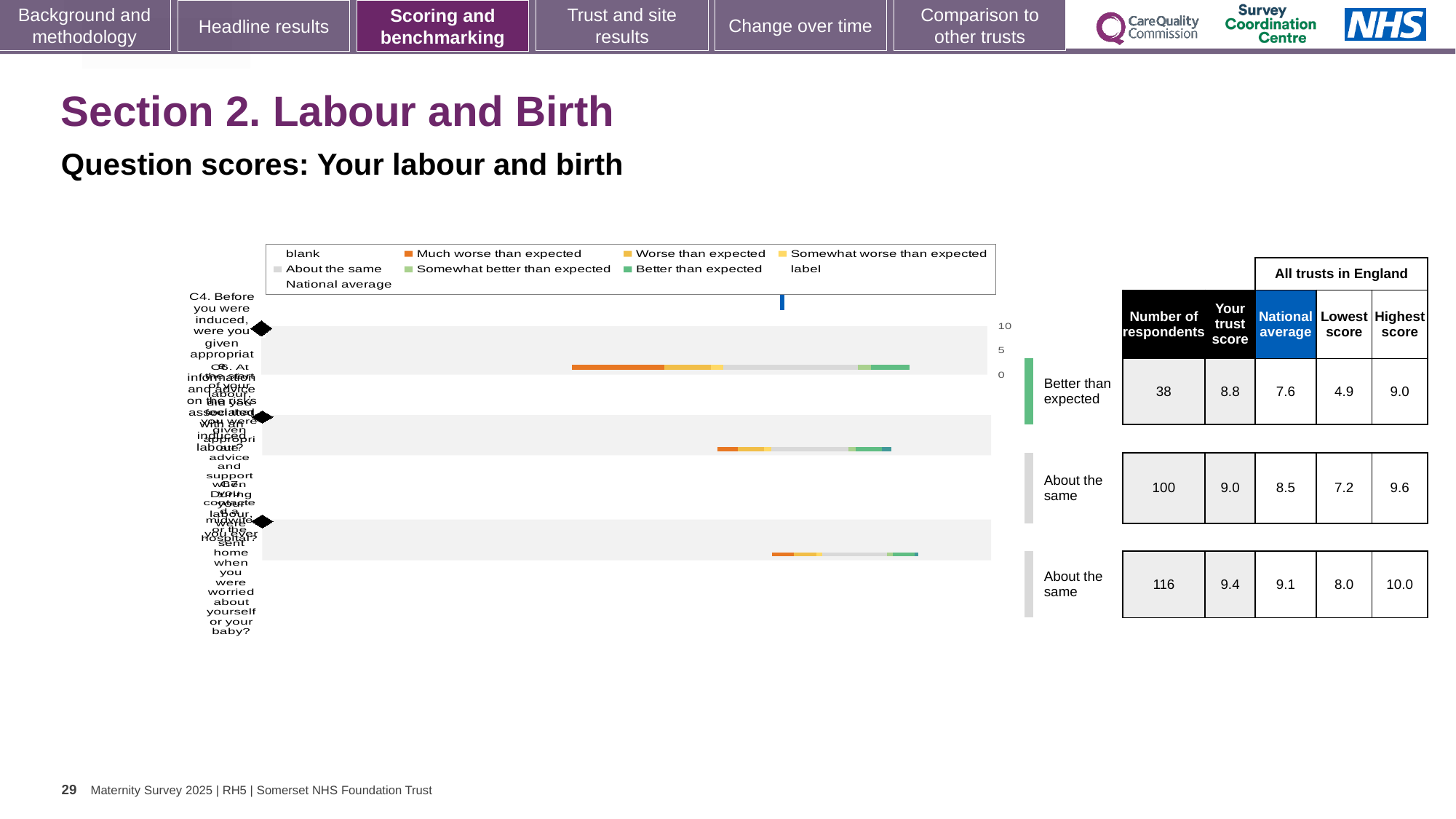
Which legend entry is shown in orange? Much worse than expected In the table beside the chart, what is the trust score for the third row (116 respondents)? 9.4 In the table beside the chart, what is the difference between the highest score and the lowest score for the third row (116 respondents)? 2.0 In the table beside the chart, what is the lowest score for the second row (100 respondents)? 7.2 How many question rows (bars) are plotted in the chart? 3 What kind of chart is shown on the slide? bar chart What is the highest tick value shown on the chart's score axis? 10 For the first row (38 respondents), which is larger: the trust score or the national average? the trust score (8.8) What benchmark label is given to the first row (38 respondents)? Better than expected Which row in the table beside the chart has the highest number of respondents? the third row (116) In the table beside the chart, what is the number of respondents for the first row? 38 In the table beside the chart, what is the national average for the second row (100 respondents)? 8.5